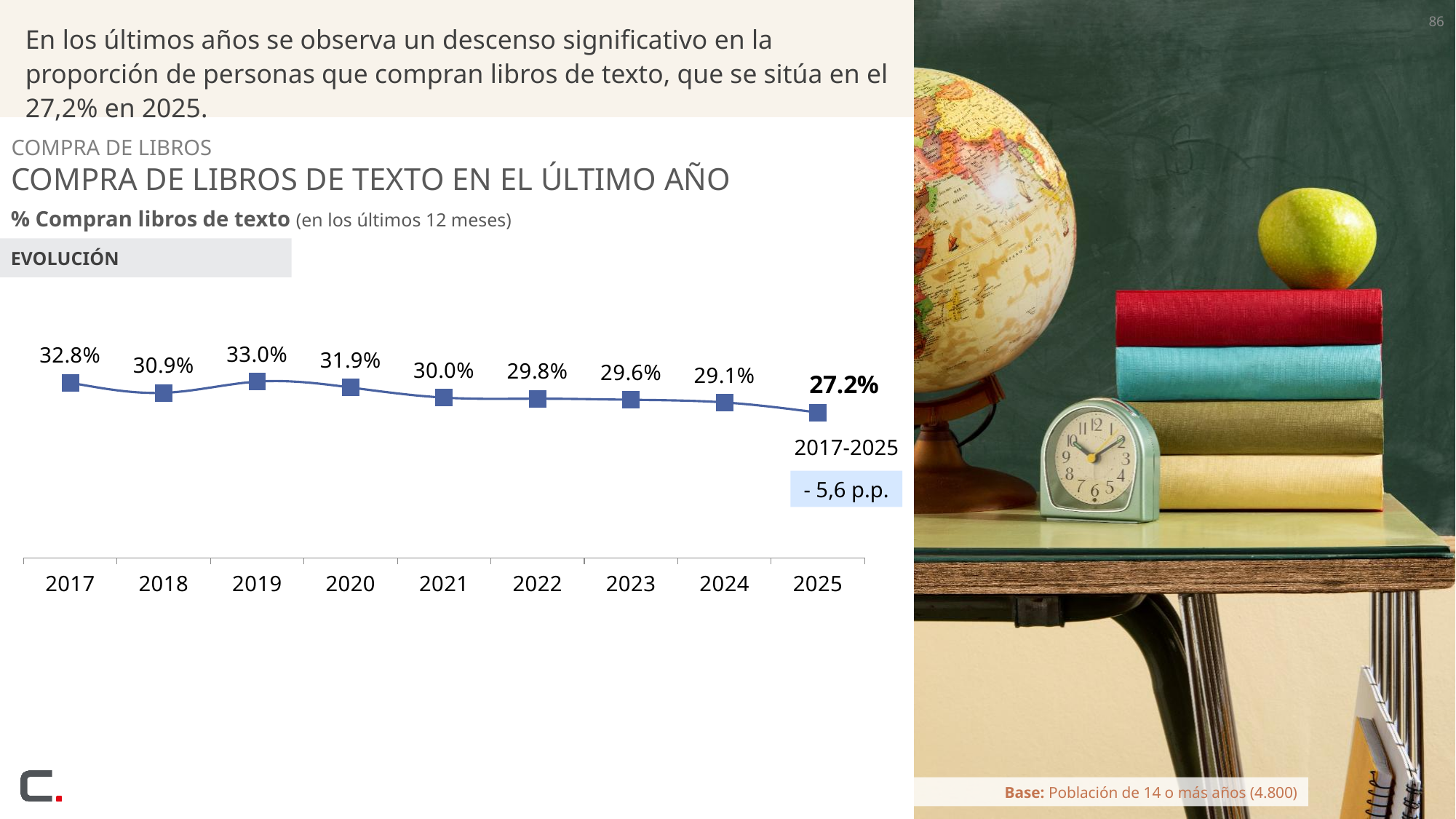
What is the value for 2021? 30.0% What is the value for 2025? 27.2% Do the values generally rise or fall from 2017 to 2025? Fall What kind of chart is shown? Line chart Which year has the lowest value? 2025 How many years are plotted on the chart? 9 What change for 2017-2025 is shown in the highlighted box on the chart? - 5,6 p.p. Which is larger, the value for 2018 or the value for 2020? 2020 What is the difference between the values for 2017 and 2025? 5.6 percentage points What is the difference between the values for 2019 and 2018? 2.1 percentage points What is the value for 2017? 32.8% Which year has the highest value? 2019